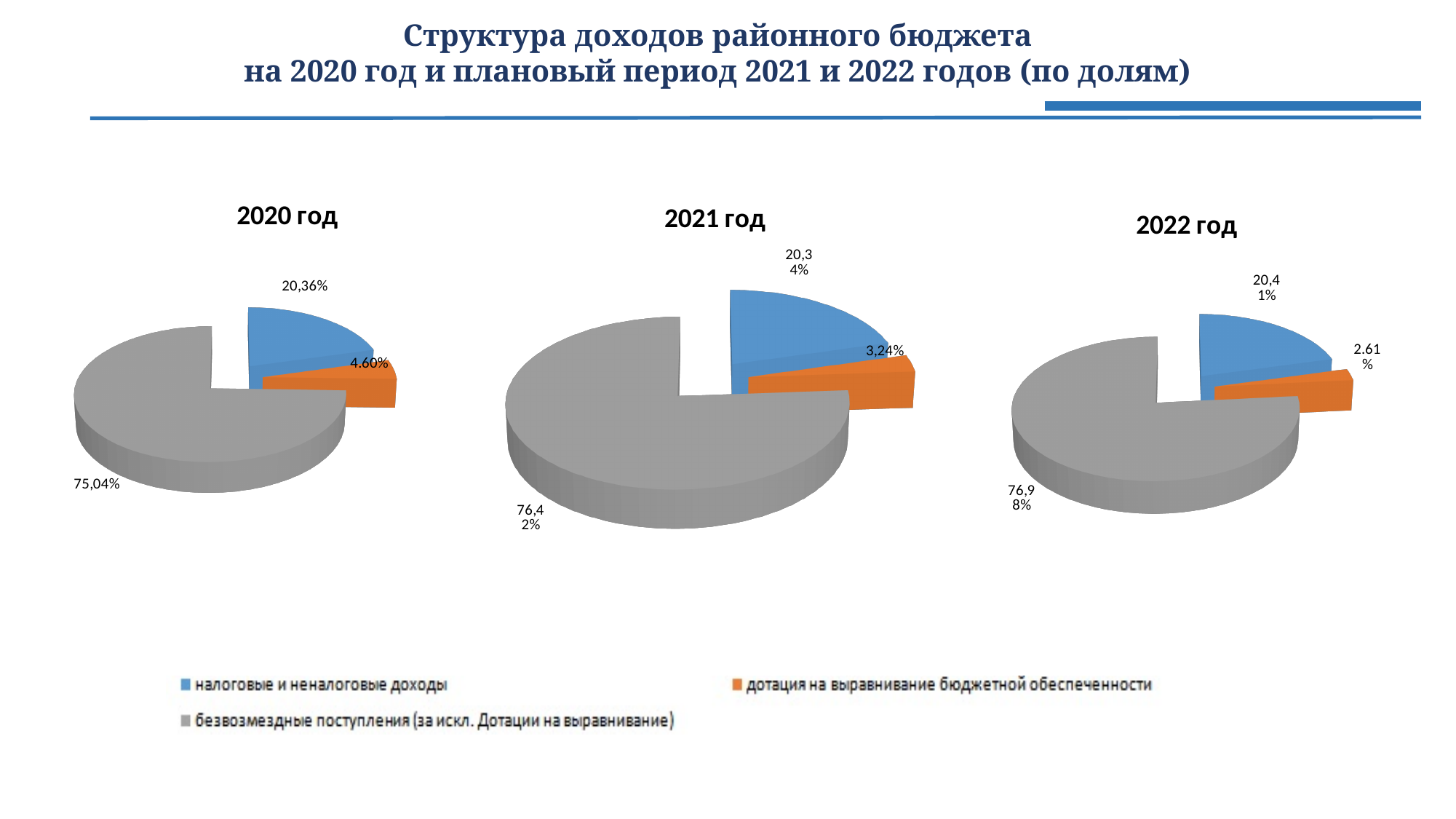
In the "2020 год" chart, what is the share of "налоговые и неналоговые доходы"? 20,36% In the "2021 год" chart, which category has the smallest slice? дотация на выравнивание бюджетной обеспеченности In the "2020 год" chart, what is the share of "дотация на выравнивание бюджетной обеспеченности"? 4,60% Which chart shows a larger share for "дотация на выравнивание бюджетной обеспеченности", "2020 год" or "2022 год"? 2020 год In the "2022 год" chart, what is the share of "безвозмездные поступления (за искл. Дотации на выравнивание)"? 76,98% In the "2021 год" chart, what is the share of "дотация на выравнивание бюджетной обеспеченности"? 3,24% What kind of chart is the "2020 год" chart? pie chart In the "2020 год" chart, which category has the largest slice? безвозмездные поступления (за искл. Дотации на выравнивание) In the "2020 год" chart, what is the difference between the share of "налоговые и неналоговые доходы" and the share of "дотация на выравнивание бюджетной обеспеченности"? 15,76% How many entries does the legend list? 3 How many pie charts are shown on the slide? 3 In the "2020 год" chart, what is the share of "безвозмездные поступления (за искл. Дотации на выравнивание)"? 75,04%